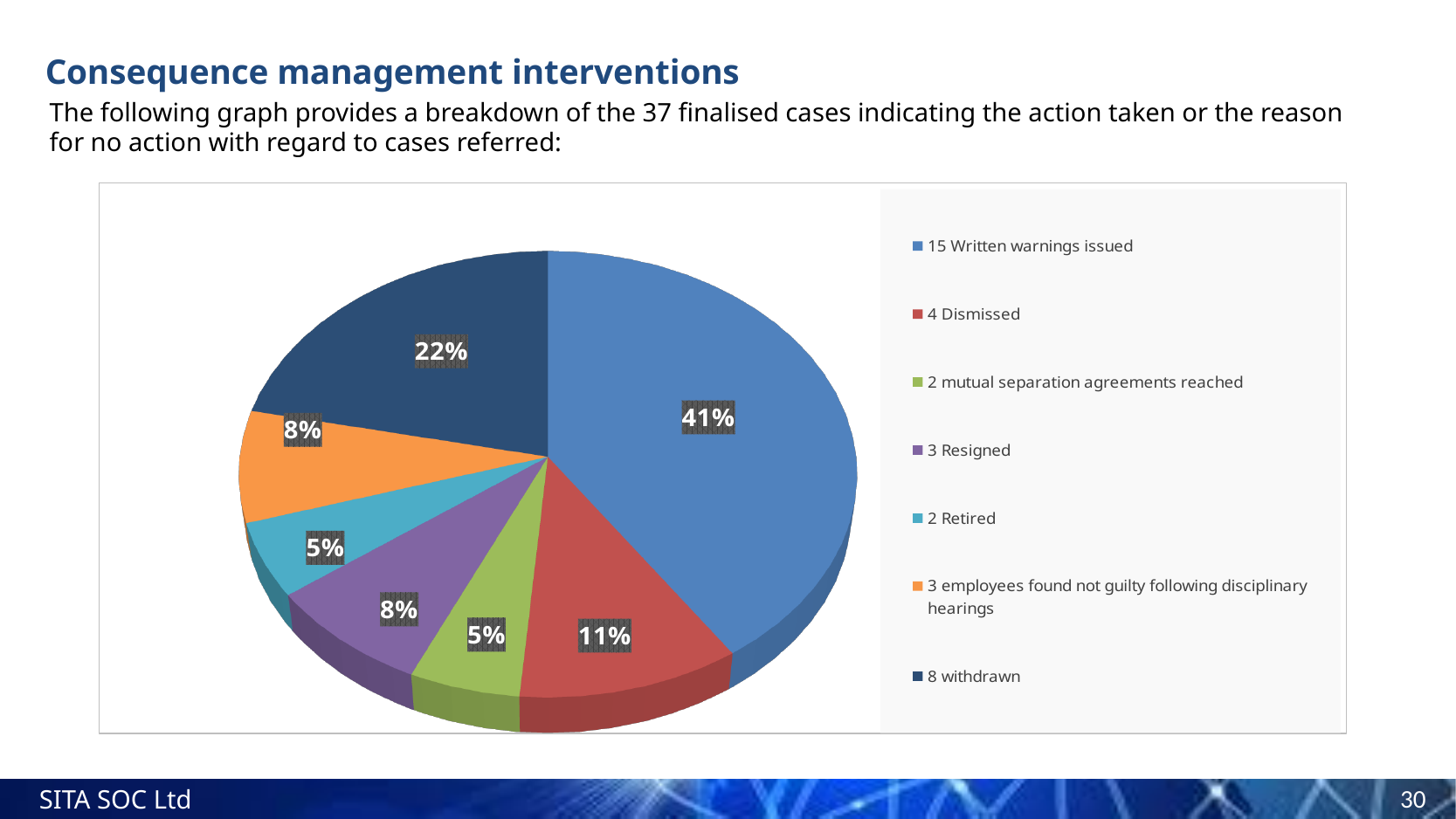
What share of the pie does 'withdrawn' represent? 22% What share of the pie does 'Resigned' represent? 8% Which category has the largest slice of the pie? Written warnings issued How many slices does the pie chart have? 7 What share of the pie does 'Dismissed' represent? 11% What type of chart is shown on the slide? pie chart How many cases does the legend give for 'Written warnings issued'? 15 What colour is the 'withdrawn' slice of the pie? dark blue What is the difference in percentage points between the 'Written warnings issued' slice and the 'withdrawn' slice? 19 Which slice is larger, 'Dismissed' or 'Retired'? Dismissed How many cases does the legend give for 'withdrawn'? 8